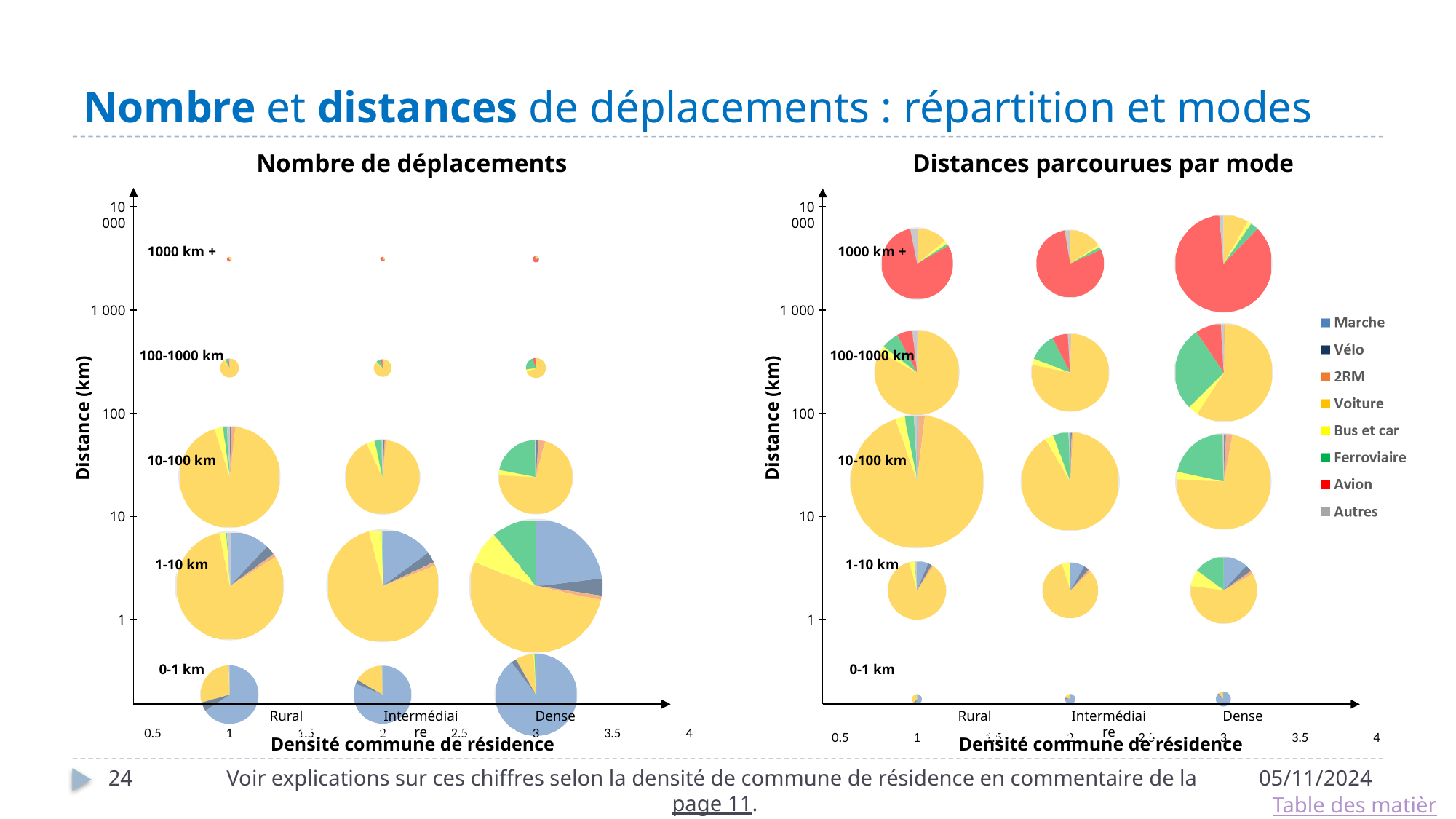
In the "Nombre de déplacements" chart, is the 1-10 km bubble larger for Rural or for Dense? Dense In the "Nombre de déplacements" chart, how many density categories are shown on the x axis? 3 In the "Distances parcourues par mode" chart, which mode takes the largest share of the 1000 km + bubbles? Avion In the "Nombre de déplacements" chart, which distance band and density has the largest bubble? 1-10 km, Dense In the "Nombre de déplacements" chart, which distance band has the smallest bubbles? 1000 km + What kind of chart is used in the "Distances parcourues par mode" chart? Pie charts (bubble chart of pies) In the "Nombre de déplacements" chart, how many distance bands are labelled along the y axis? 5 In the "Distances parcourues par mode" chart, is the 10-100 km bubble larger for Rural or for Dense? Rural How many series does the legend on the slide list? 8 In the "Nombre de déplacements" chart, which mode takes the largest share of the 0-1 km bubble for Dense? Marche What is the title of the y axis on both charts? Distance (km) In the "Distances parcourues par mode" chart, which distance band and density has the largest bubble? 10-100 km, Rural